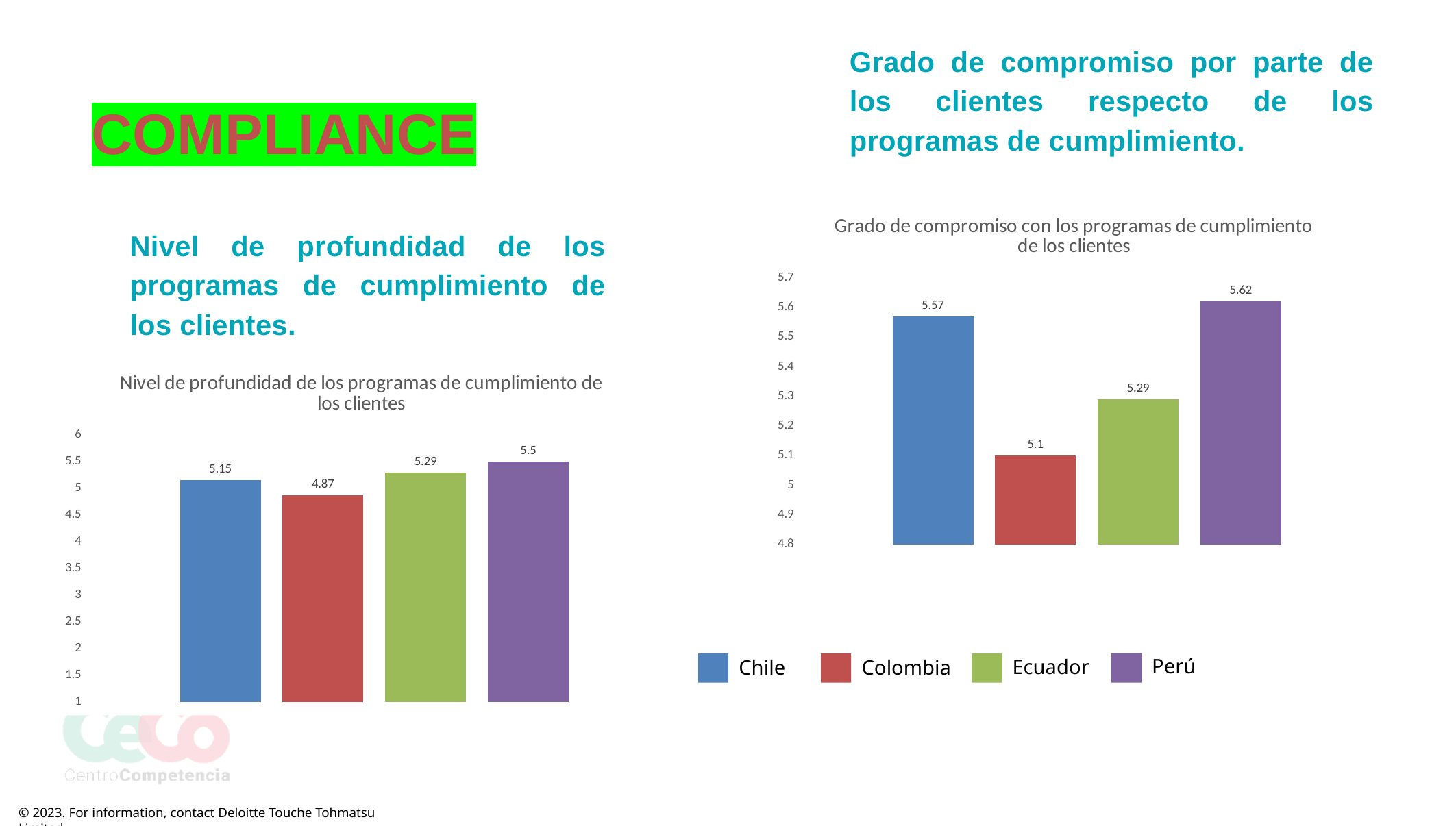
In the chart titled 'Grado de compromiso con los programas de cumplimiento de los clientes', what is the value for Ecuador? 5.29 What type of chart is the chart titled 'Grado de compromiso con los programas de cumplimiento de los clientes'? Bar chart In the chart titled 'Nivel de profundidad de los programas de cumplimiento de los clientes', what is the value for Perú? 5.5 In the chart titled 'Grado de compromiso con los programas de cumplimiento de los clientes', what is the difference between Chile and Colombia? 0.47 In the chart titled 'Grado de compromiso con los programas de cumplimiento de los clientes', which country has the lowest value? Colombia In the chart titled 'Nivel de profundidad de los programas de cumplimiento de los clientes', what is the value for Colombia? 4.87 In the chart titled 'Grado de compromiso con los programas de cumplimiento de los clientes', is the value for Colombia greater or less than 5.2? less In the chart titled 'Grado de compromiso con los programas de cumplimiento de los clientes', which country has the highest value? Perú In the chart titled 'Grado de compromiso con los programas de cumplimiento de los clientes', what is the value for Chile? 5.57 How many countries are shown in the chart titled 'Nivel de profundidad de los programas de cumplimiento de los clientes'? 4 In the chart titled 'Nivel de profundidad de los programas de cumplimiento de los clientes', which country has the lowest value? Colombia In the chart titled 'Nivel de profundidad de los programas de cumplimiento de los clientes', what is the difference between Perú and Chile? 0.35